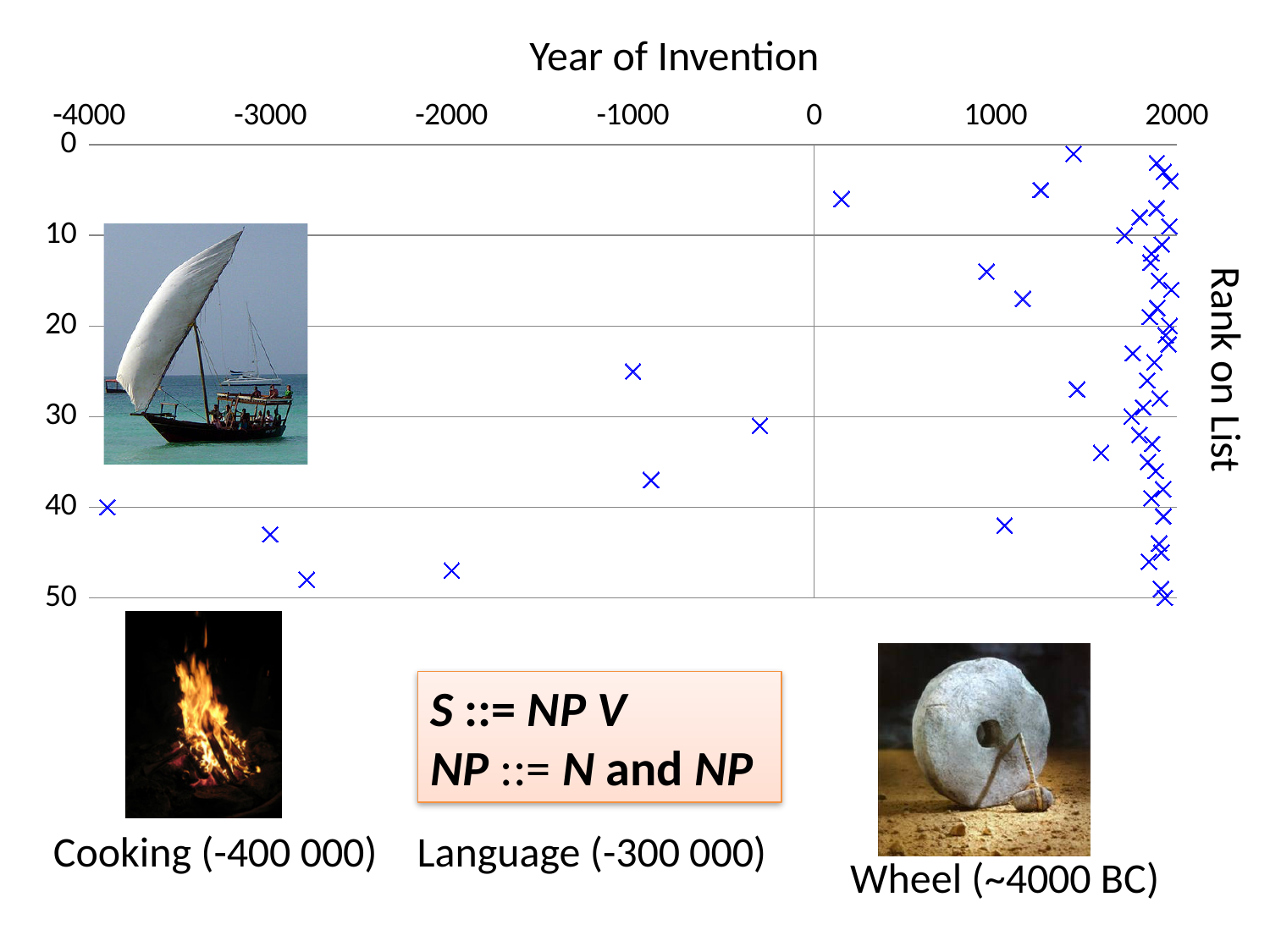
Is the rank of the point plotted near year -1000 with the smallest rank greater or less than 20? greater Is the year of invention for the point with rank 50 greater or less than 1000? greater Is the rank of the point plotted just after year 0 greater or less than 10? less What kind of chart is shown on the slide? Scatter chart What is the title of the horizontal axis of the chart? Year of Invention What is the title of the vertical axis of the chart? Rank on List